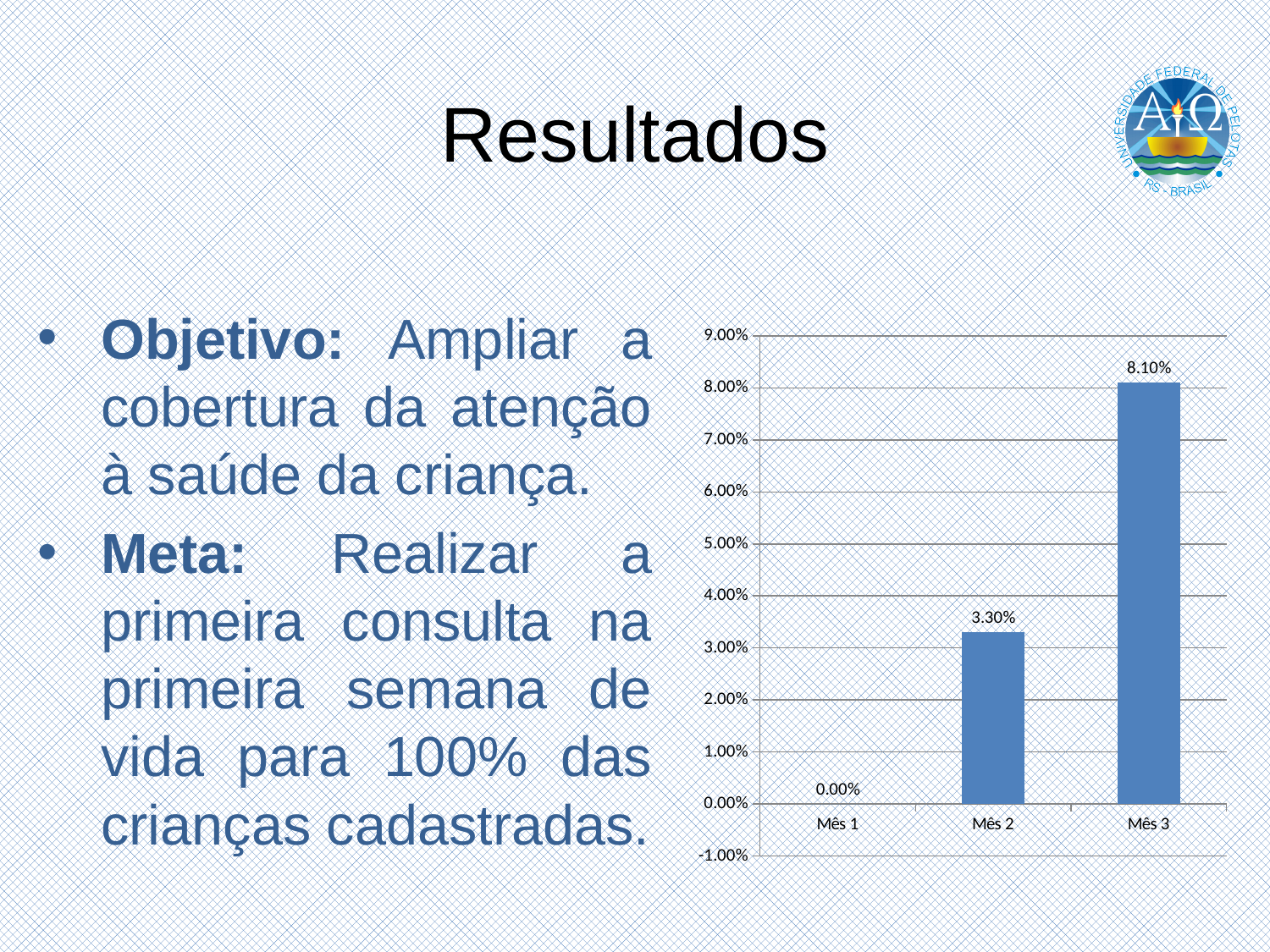
How many categories are shown on the x axis? 3 Is the value for Mês 2 greater or less than 4.00%? less What is the difference between the values for Mês 3 and Mês 2? 4.80% Which category has the highest value? Mês 3 Do the values rise or fall from Mês 1 to Mês 3? rise Is the value for Mês 3 greater or less than 7.00%? greater Which category has the lowest value? Mês 1 What is the value for Mês 2? 3.30% Which is larger, the value for Mês 2 or the value for Mês 3? Mês 3 What is the value for Mês 1? 0.00% What is the value for Mês 3? 8.10% What kind of chart is shown on the slide? bar chart